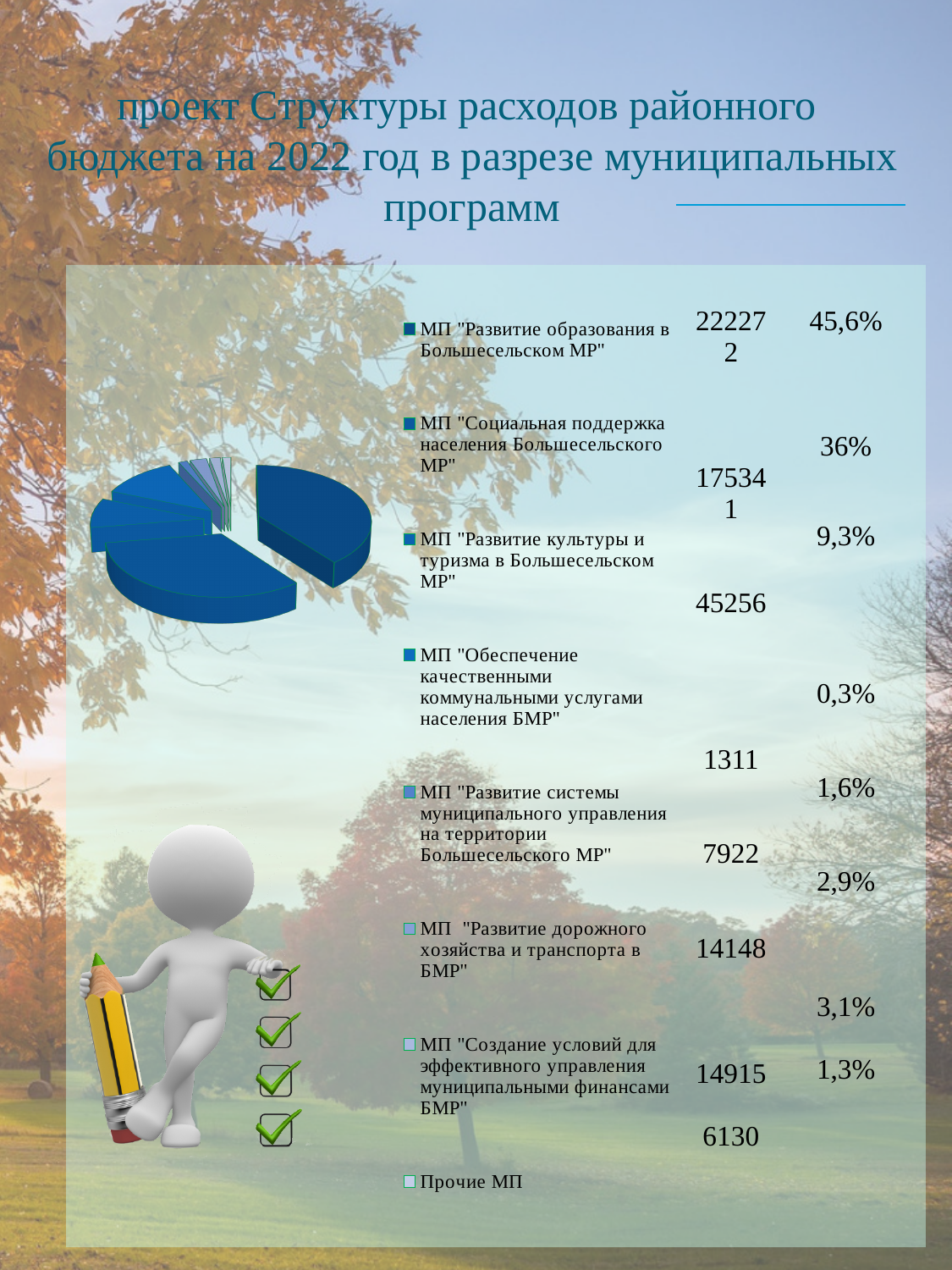
What percentage share is shown for МП "Развитие образования в Большесельском МР"? 45,6% What kind of chart is shown on the slide? pie chart Which is larger: the share for МП "Развитие образования в Большесельском МР" or the share for МП "Социальная поддержка населения Большесельского МР"? МП "Развитие образования в Большесельском МР" What is the title of the slide containing the chart? проект Структуры расходов районного бюджета на 2022 год в разрезе муниципальных программ What is the last entry listed in the chart legend? Прочие МП Which programme has the largest slice of the pie? МП "Развитие образования в Большесельском МР" What value is shown for МП "Социальная поддержка населения Большесельского МР"? 175341 How many entries does the chart legend list? 8 What is the difference in percentage points between the 45,6% share and the 36% share? 9,6 What percentage share is shown for МП "Социальная поддержка населения Большесельского МР"? 36% Is the share for МП "Развитие образования в Большесельском МР" greater or less than 40%? greater What value is shown for МП "Развитие образования в Большесельском МР"? 222272